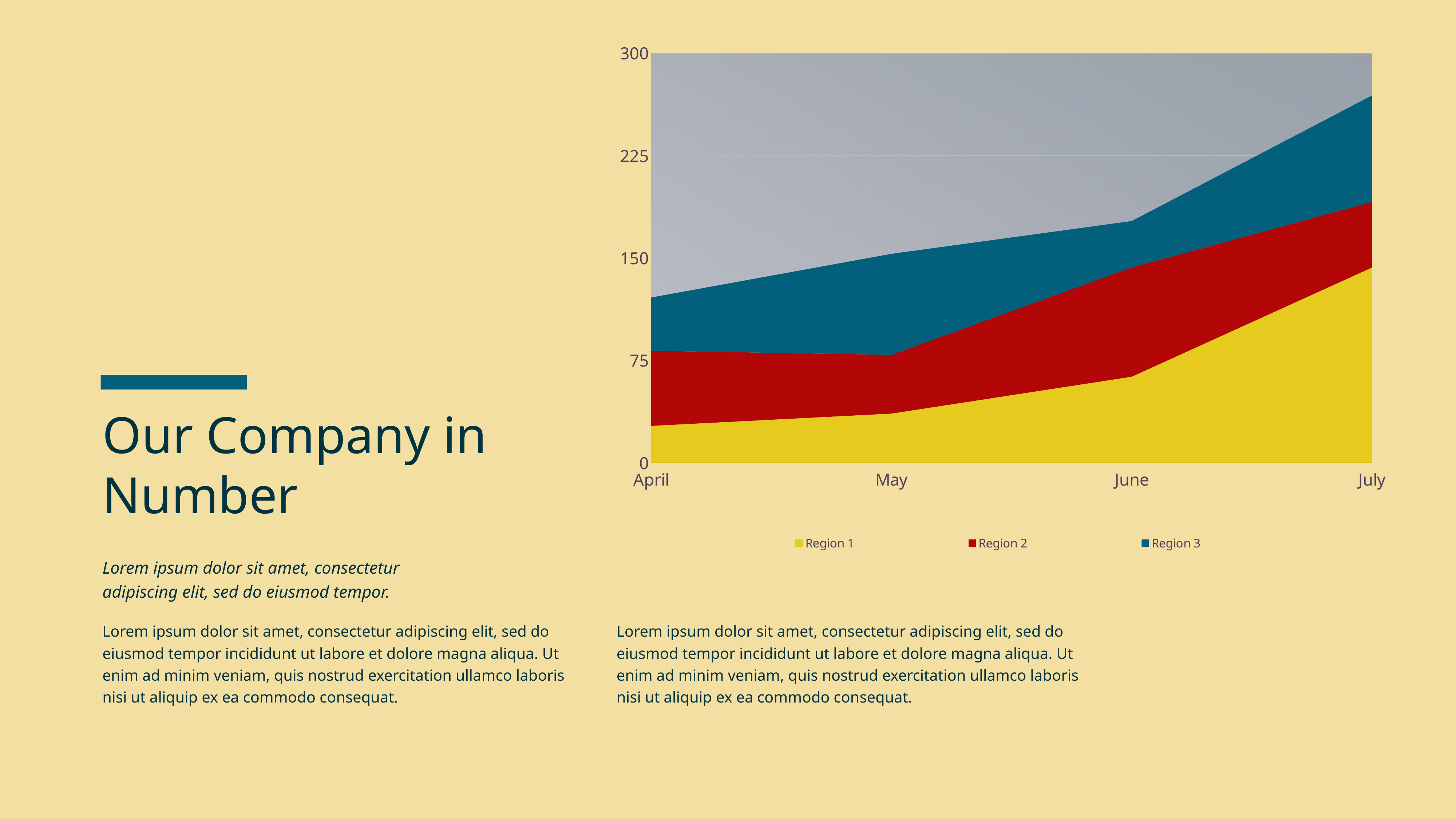
Which colour represents Region 2 in the chart? Red Is the value for Region 1 larger in July or in April? July What kind of chart is shown on the slide? Stacked area chart Which month has the highest stacked total? July Is the value for Region 1 in July greater or less than 75? greater Is the stacked total in July greater or less than 225? greater How many series does the legend list? 3 Is the stacked total in April greater or less than 150? less How many months are shown on the x axis? 4 Which month has the lowest stacked total? April Does the stacked total rise or fall from April to July? rise